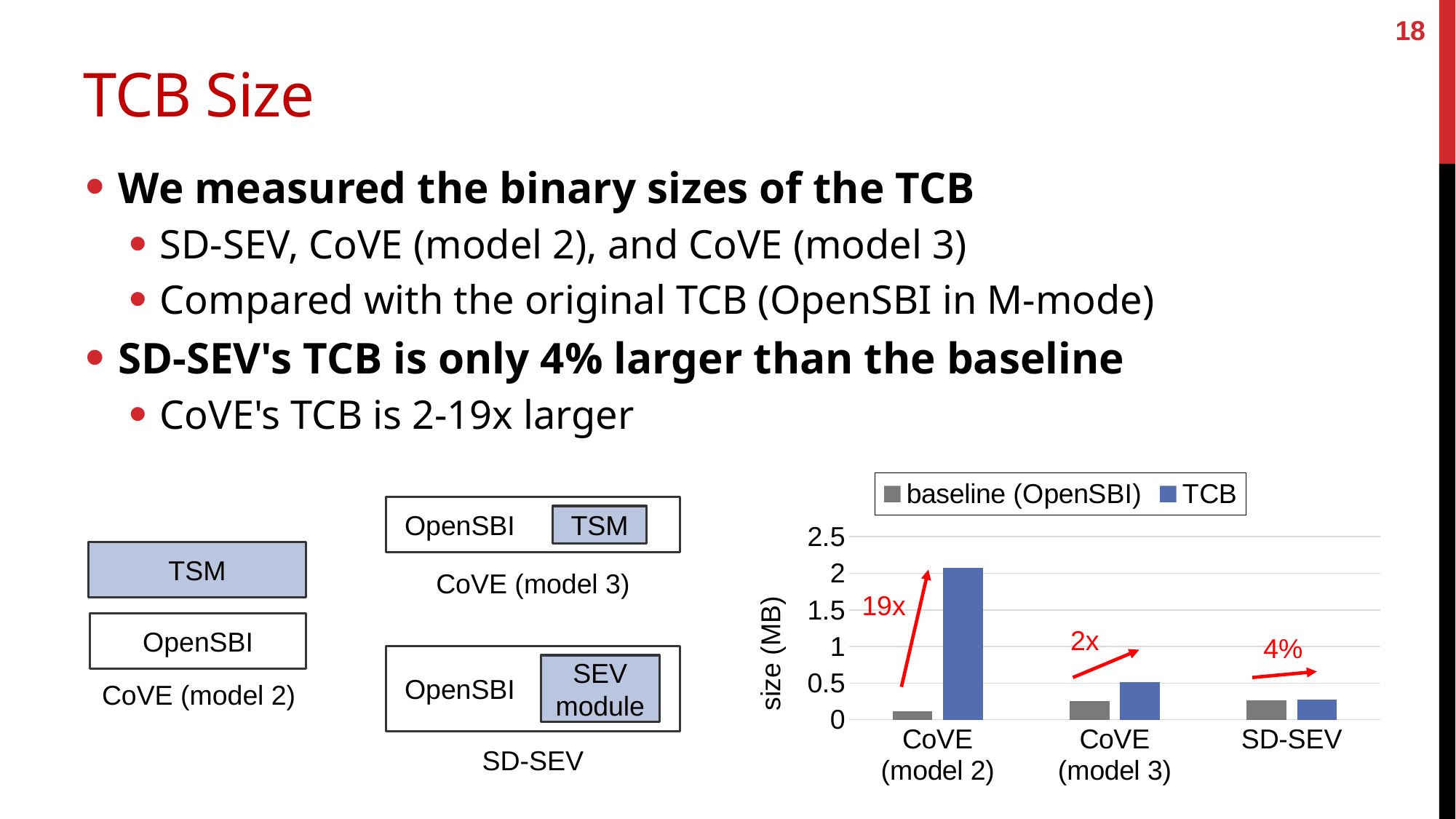
Is the TCB value for CoVE (model 3) greater or less than 1? less Which category has the lowest TCB value in the chart? SD-SEV Is the TCB value for CoVE (model 2) greater or less than 1.5? greater What kind of chart is shown on the slide? bar chart How many categories are shown on the x axis of the chart? 3 Is the TCB value for SD-SEV greater or less than 0.5? less What annotation is written in red above the SD-SEV bars in the chart? 4% What is the label on the y axis of the chart? size (MB) Which is larger for CoVE (model 3): the baseline (OpenSBI) value or the TCB value? TCB How many series does the chart legend list? 2 Which category has the highest TCB value in the chart? CoVE (model 2)